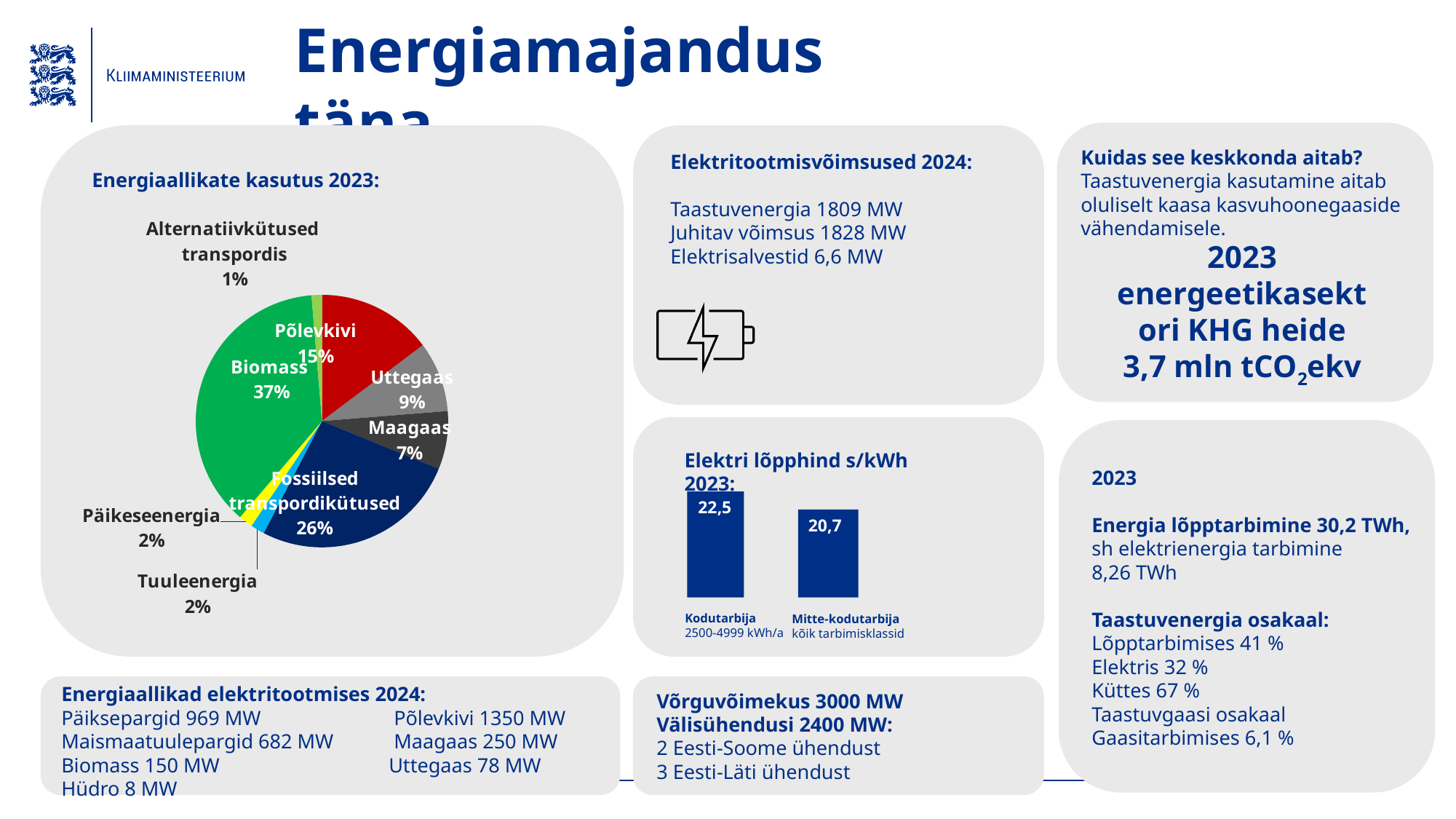
In the pie chart 'Energiaallikate kasutus 2023', what share does Biomass have? 37% What kind of chart is 'Elektri lõpphind s/kWh 2023'? Bar chart What kind of chart is 'Energiaallikate kasutus 2023'? Pie chart In the pie chart 'Energiaallikate kasutus 2023', how many percentage points larger is Uttegaas than Maagaas? 2 How many slices does the pie chart 'Energiaallikate kasutus 2023' have? 8 In the pie chart 'Energiaallikate kasutus 2023', what share does Põlevkivi have? 15% In the bar chart 'Elektri lõpphind s/kWh 2023', what is the value for Kodutarbija? 22,5 In the bar chart 'Elektri lõpphind s/kWh 2023', what is the difference between Kodutarbija and Mitte-kodutarbija? 1,8 In the pie chart 'Energiaallikate kasutus 2023', what share do Fossiilsed transpordikütused have? 26% In the pie chart 'Energiaallikate kasutus 2023', which category has the smallest share? Alternatiivkütused transpordis In the pie chart 'Energiaallikate kasutus 2023', which category has the largest share? Biomass In the pie chart 'Energiaallikate kasutus 2023', which is larger: Põlevkivi or Uttegaas? Põlevkivi